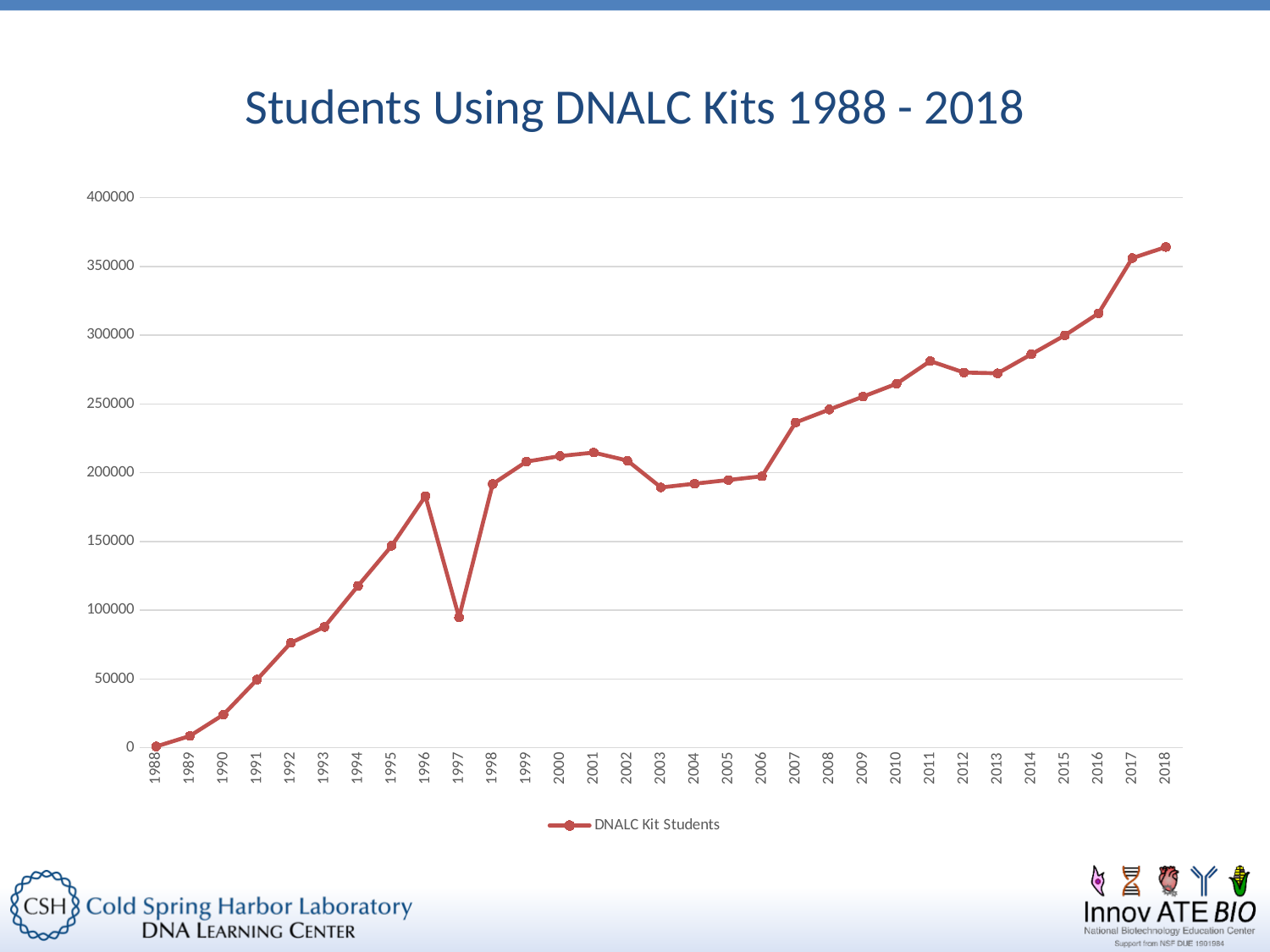
What is the title of the chart? Students Using DNALC Kits 1988 - 2018 How many series does the legend list? 1 Is the value for 1997 greater or less than 100000? less Is the value for 1996 greater or less than 150000? greater Is the value for 2017 greater or less than 350000? greater Which year has the larger value, 1996 or 1997? 1996 Which year has the highest number of DNALC Kit Students? 2018 What kind of chart is shown on the slide? line chart How many years (data points) are plotted on the chart? 31 Which year has the lowest number of DNALC Kit Students? 1988 Overall, do the values rise or fall from 1988 to 2018? rise